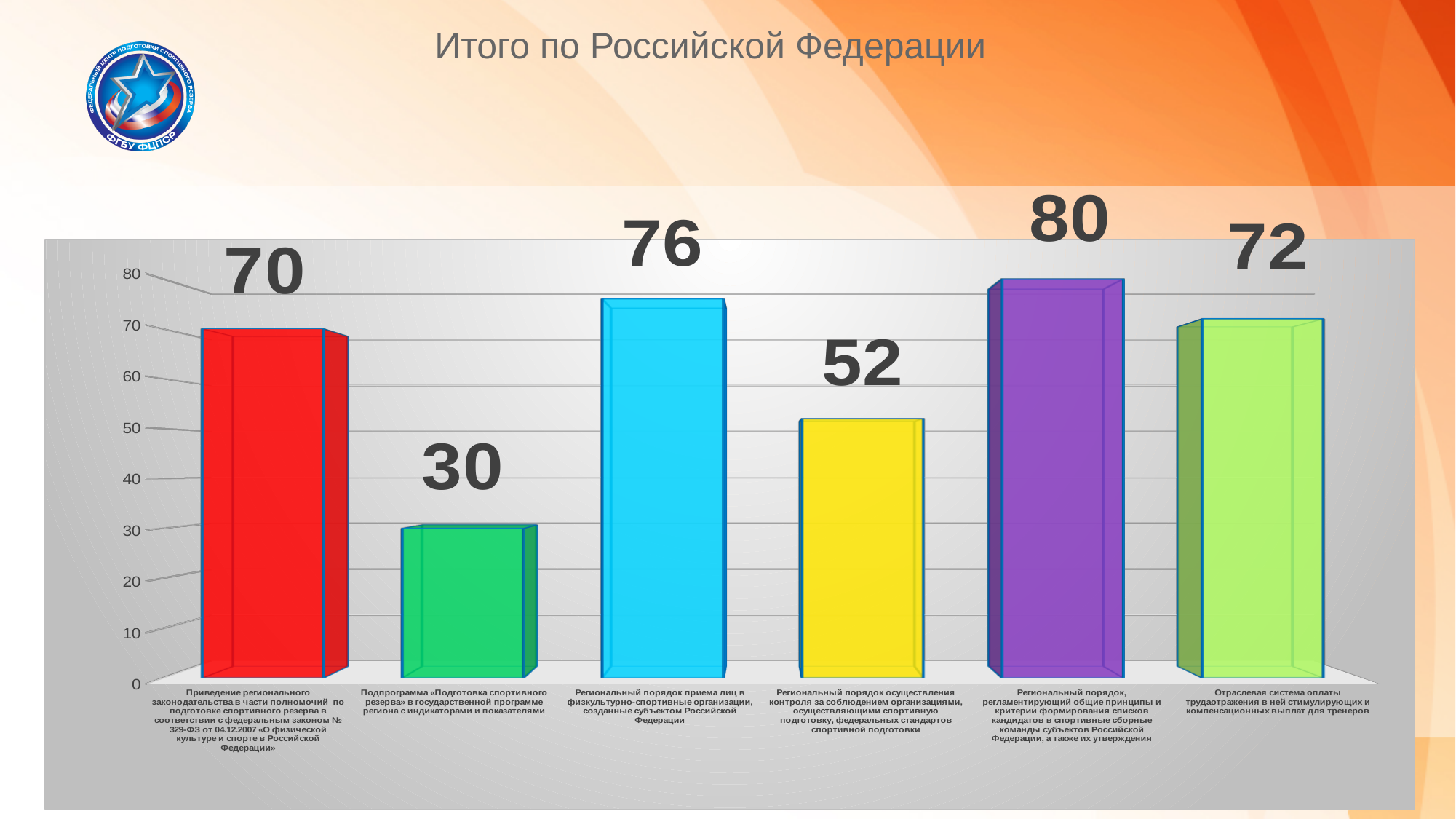
What is the difference between the value for «Региональный порядок приема лиц в физкультурно-спортивные организации...» (76) and «Региональный порядок осуществления контроля...» (52)? 24 What is the value for «Отраслевая система оплаты труда, отражения в ней стимулирующих и компенсационных выплат для тренеров»? 72 What is the title of the slide? Итого по Российской Федерации What is the value for «Региональный порядок приема лиц в физкультурно-спортивные организации, созданные субъектом Российской Федерации»? 76 Which is larger: the value for «Приведение регионального законодательства...» or the value for «Отраслевая система оплаты труда...»? Отраслевая система оплаты труда... What kind of chart is shown on the slide? bar chart What is the difference between the highest value (80) and the lowest value (30)? 50 Is the value for «Региональный порядок осуществления контроля...» greater or less than 60? less How many categories (bars) are shown in the chart? 6 Which category has the highest value? Региональный порядок, регламентирующий общие принципы и критерии формирования списков кандидатов в спортивные сборные команды субъектов Российской Федерации, а также их утверждения What is the value for «Подпрограмма «Подготовка спортивного резерва» в государственной программе региона с индикаторами и показателями»? 30 Which category has the lowest value? Подпрограмма «Подготовка спортивного резерва» в государственной программе региона с индикаторами и показателями